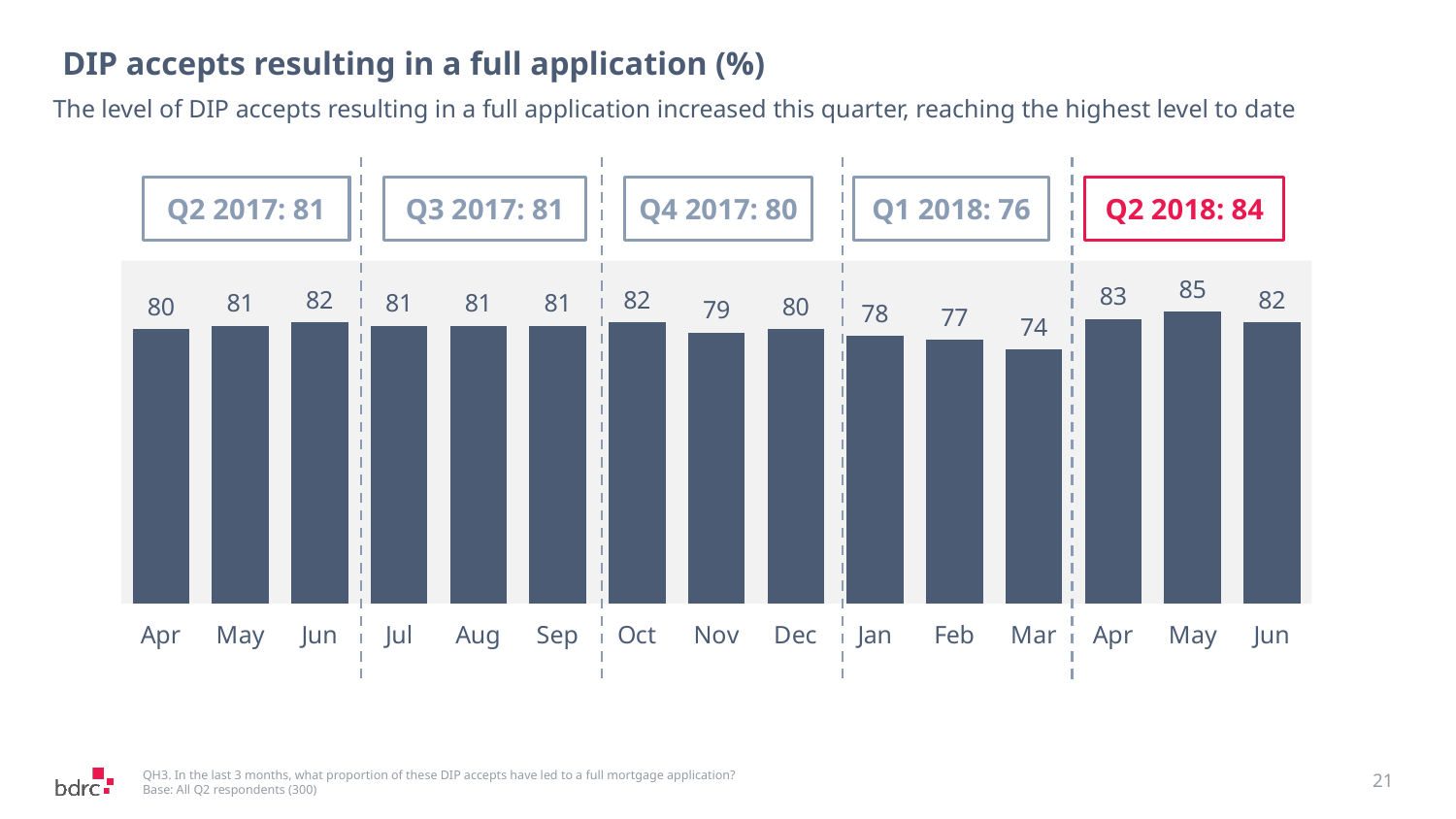
What is the quarterly value shown in the box for Q1 2018? 76 What is the value for May in the Q2 2018 section? 85 Which month has the highest value? May (Q2 2018) Which is larger, the value for Nov or the value for Dec? Dec What is the difference between the values for Feb and Mar? 3 What is the value for Mar? 74 What is the value for Oct? 82 Which month has the lowest value? Mar What is the difference between the Q2 2018 and Q1 2018 quarterly values shown in the boxes? 8 How many monthly bars are plotted in the chart? 15 What kind of chart is shown on the slide? Bar chart Do the values rise or fall from Jan to Mar? Fall